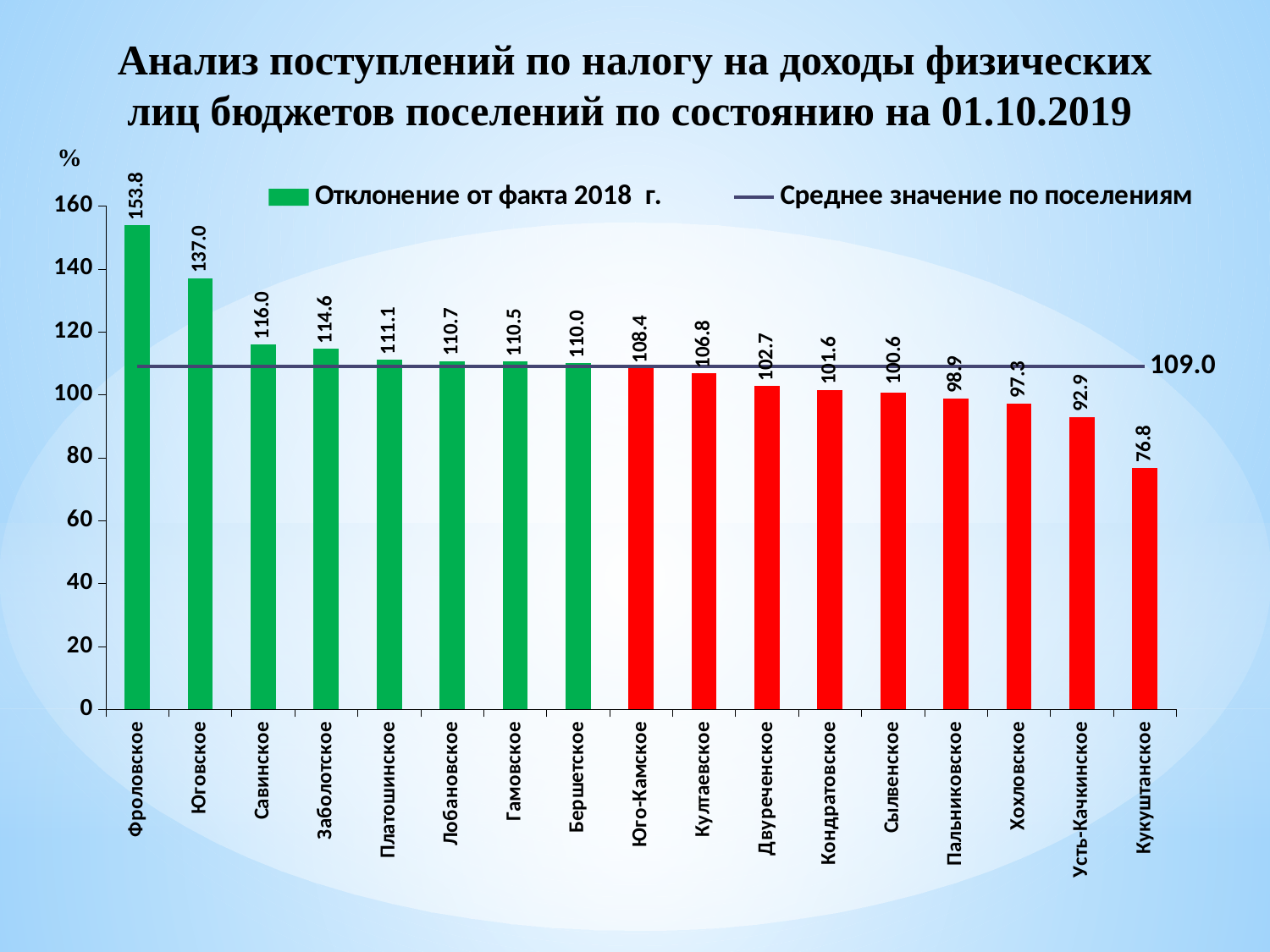
What is the value for Фроловское? 153.8 Which settlement has the highest value? Фроловское What kind of chart is shown on the slide? Bar chart What is the value for Сылвенское? 100.6 Which is larger, the value for Савинское or the value for Култаевское? Савинское What is the difference between the values for Фроловское and Юговское? 16.8 What is the value of the average line (Среднее значение по поселениям)? 109.0 Do the bar values rise or fall from left to right along the x axis? Fall Which settlement has the lowest value? Кукуштанское What is the value for Кукуштанское? 76.8 How many entries does the legend list? 2 How many settlements are shown on the x axis? 17